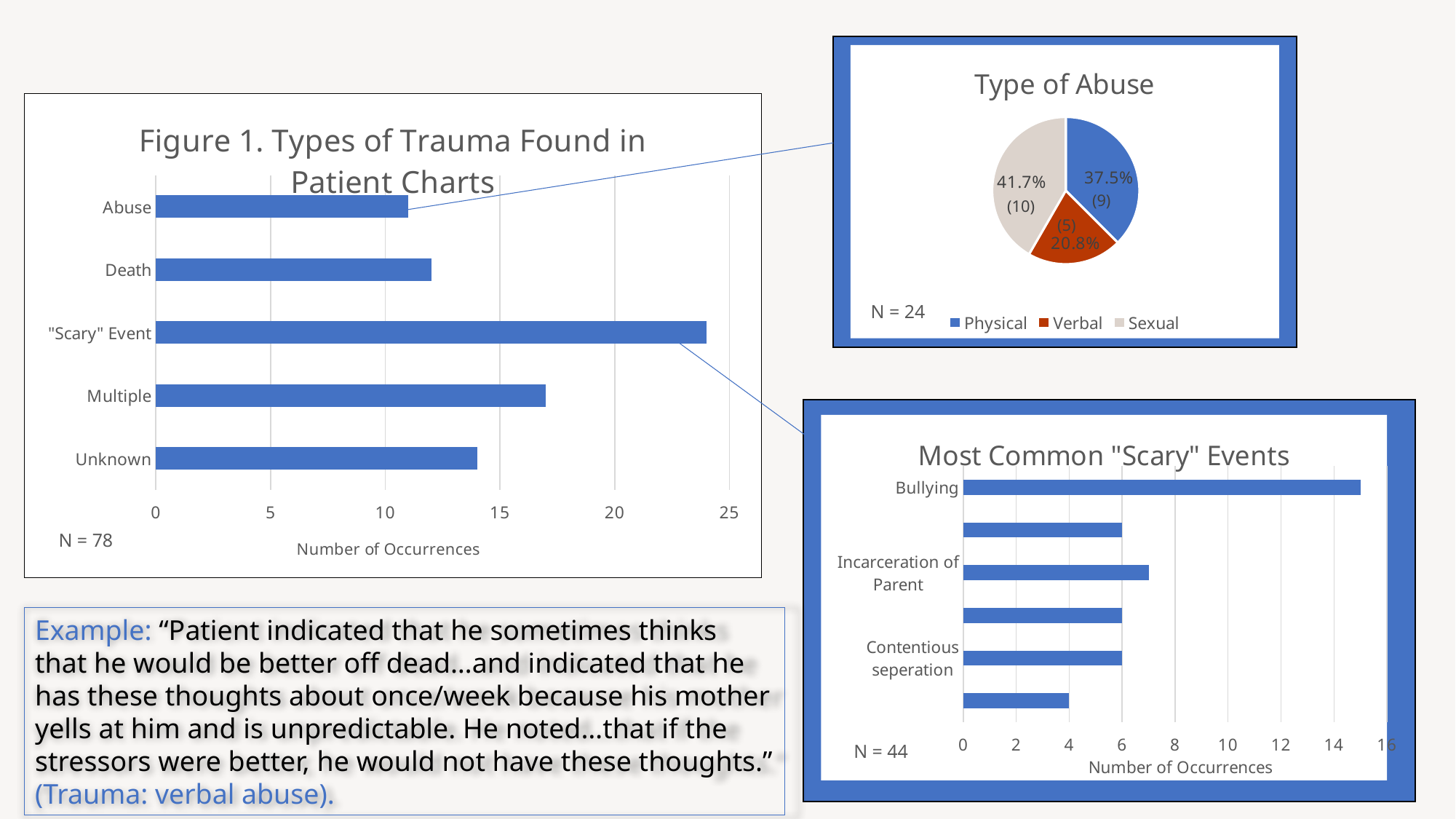
In the "Type of Abuse" pie chart, which type has the largest share? Sexual What kind of chart is "Figure 1. Types of Trauma Found in Patient Charts"? bar chart In "Figure 1. Types of Trauma Found in Patient Charts", which category has the highest number of occurrences? "Scary" Event How many entries does the legend of the "Type of Abuse" pie chart list? 3 In the "Type of Abuse" pie chart, how many cases are Sexual? 10 In "Figure 1. Types of Trauma Found in Patient Charts", which is larger, Multiple or Unknown? Multiple How many categories are shown in "Figure 1. Types of Trauma Found in Patient Charts"? 5 In the "Most Common "Scary" Events" chart, which event has the highest number of occurrences? Bullying In the "Most Common "Scary" Events" chart, is the value for Bullying greater or less than 14? greater In "Figure 1. Types of Trauma Found in Patient Charts", is the value for "Scary" Event greater or less than 20? greater In "Figure 1. Types of Trauma Found in Patient Charts", is the value for Multiple greater or less than 15? greater In the "Type of Abuse" pie chart, what percentage is Physical? 37.5%